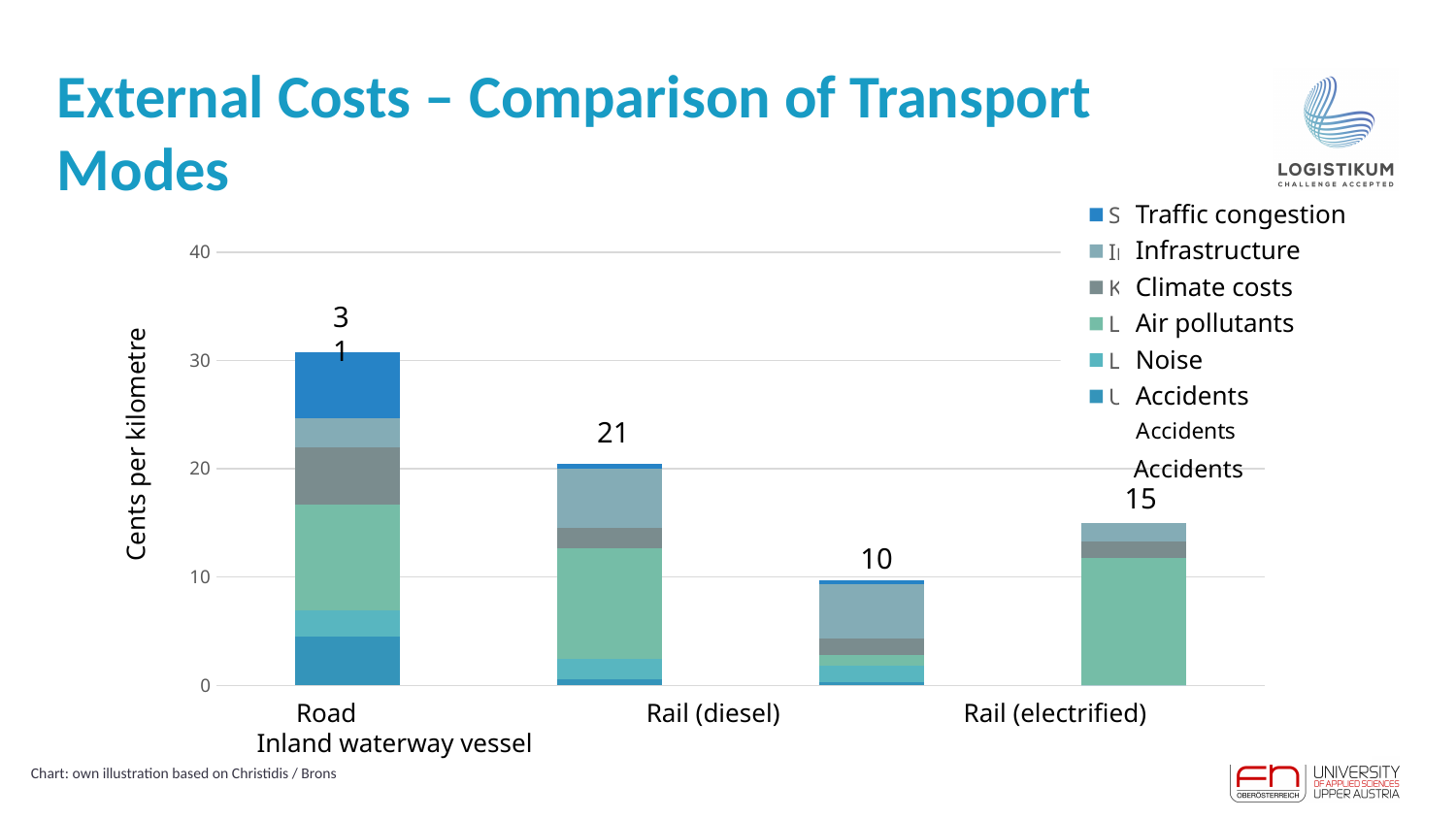
What is the title of the vertical axis? Cents per kilometre Is the total value for Road greater or less than 20? greater What is the total external cost value labelled for Rail (electrified)? 10 What value is labelled above the rightmost bar in the chart? 15 How many series does the legend list? 6 What is the total external cost value labelled for Rail (diesel)? 21 Which bar has the lowest total external cost in the chart? Rail (electrified) What kind of chart is shown on the slide? bar chart What is the difference between the total values for Rail (diesel) and Rail (electrified)? 11 Which has a larger total external cost, Rail (diesel) or Rail (electrified)? Rail (diesel) How many bars are plotted in the chart? 4 Which transport mode has the highest total external cost in the chart? Road